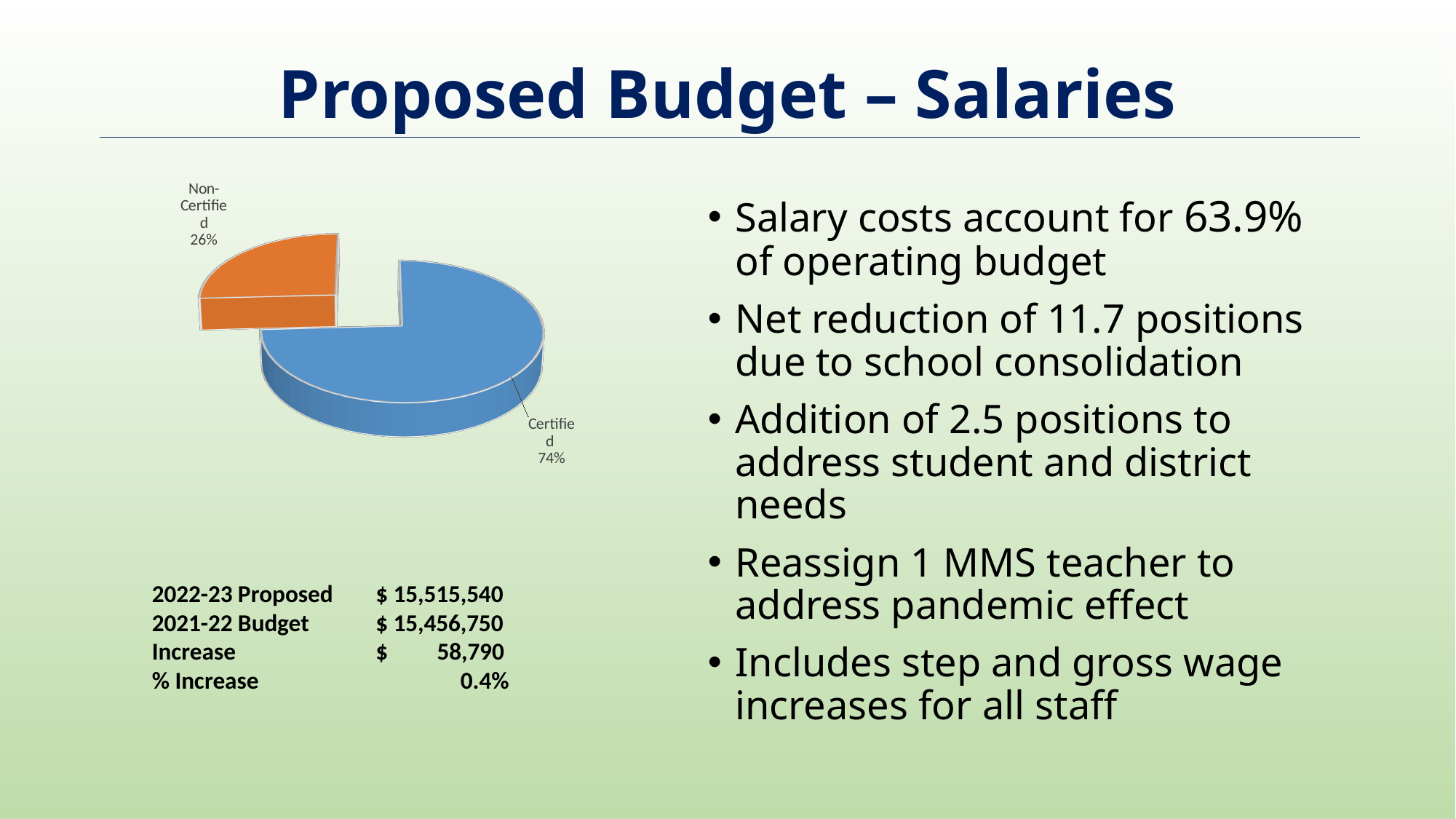
What share of the pie does the Non-Certified slice represent? 26% What kind of chart is shown on the slide? Pie chart How many slices does the pie chart have? 2 Which is larger, the Certified slice or the Non-Certified slice? Certified Is the share for Non-Certified greater or less than 50%? less What colour is the Certified slice of the pie? Blue Which slice of the pie is the largest? Certified Which slice of the pie is the smallest? Non-Certified What is the difference in percentage points between the Certified and Non-Certified slices? 48 What colour is the Non-Certified slice of the pie? Orange What share of the pie does the Certified slice represent? 74%